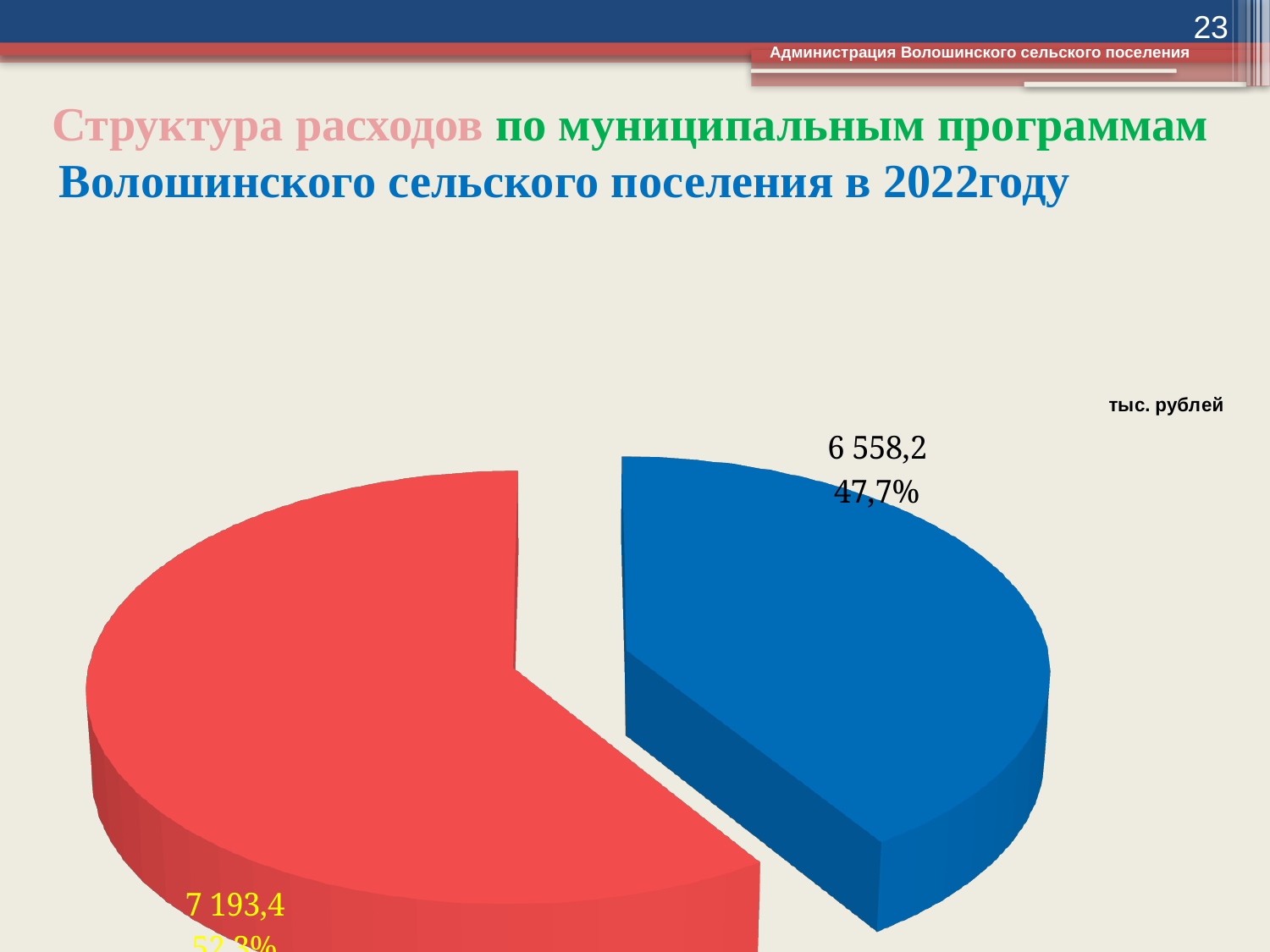
What kind of chart is shown on the slide? pie chart What value is labelled on the blue slice of the pie chart? 6 558,2 What value is labelled on the red slice of the pie chart? 7 193,4 What is the difference between the value of the red slice and the value of the blue slice? 635,2 Which slice of the pie chart is the smallest? the blue slice What unit is indicated for the values in the pie chart? тыс. рублей Which slice has the larger value, the red slice or the blue slice? the red slice Which slice of the pie chart is the largest? the red slice Which year does the slide title say the expenditure structure refers to? 2022 How many slices does the pie chart have? 2 What is the total of the two values shown on the pie chart? 13 751,6 What percentage share is labelled on the blue slice of the pie chart? 47,7%